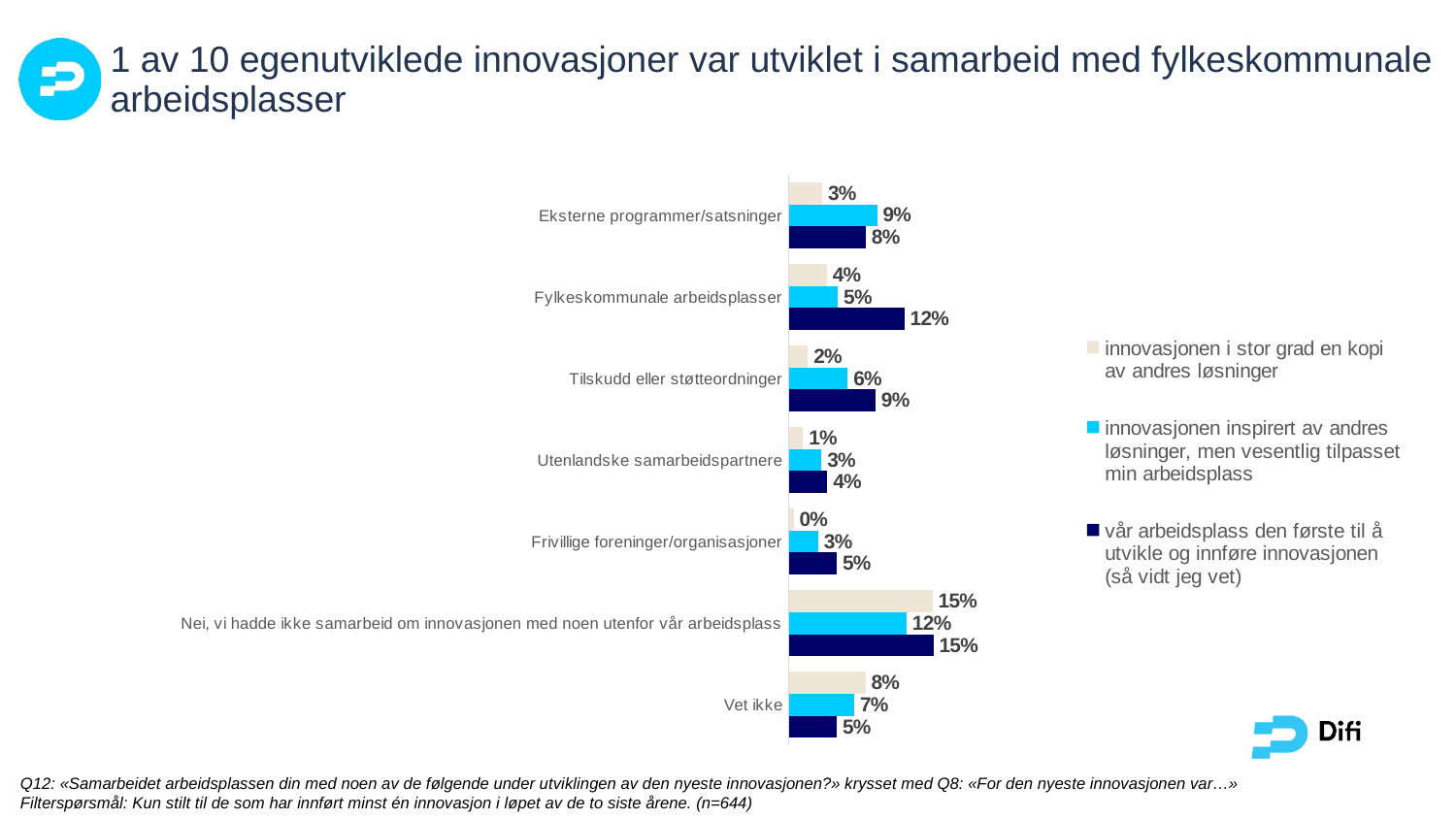
How many categories are shown on the chart? 7 What is the value for Frivillige foreninger/organisasjoner in the series 'innovasjonen i stor grad en kopi av andres løsninger'? 0% Which category has the highest value in the series 'innovasjonen i stor grad en kopi av andres løsninger'? Nei, vi hadde ikke samarbeid om innovasjonen med noen utenfor vår arbeidsplass What is the value for Eksterne programmer/satsninger in the series 'innovasjonen inspirert av andres løsninger, men vesentlig tilpasset min arbeidsplass'? 9% What is the difference between the 'vår arbeidsplass den første til å utvikle og innføre innovasjonen (så vidt jeg vet)' value and the 'innovasjonen i stor grad en kopi av andres løsninger' value for Tilskudd eller støtteordninger? 7% Which category has the lowest value in the series 'innovasjonen inspirert av andres løsninger, men vesentlig tilpasset min arbeidsplass'? Utenlandske samarbeidspartnere and Frivillige foreninger/organisasjoner (both 3%) Which colour represents the series 'vår arbeidsplass den første til å utvikle og innføre innovasjonen (så vidt jeg vet)'? dark blue What is the value for Vet ikke in the series 'innovasjonen i stor grad en kopi av andres løsninger'? 8% What is the value for Fylkeskommunale arbeidsplasser in the series 'vår arbeidsplass den første til å utvikle og innføre innovasjonen (så vidt jeg vet)'? 12% For Vet ikke, which is larger: the value for 'innovasjonen i stor grad en kopi av andres løsninger' or the value for 'vår arbeidsplass den første til å utvikle og innføre innovasjonen (så vidt jeg vet)'? innovasjonen i stor grad en kopi av andres løsninger How many series does the legend list? 3 What kind of chart is shown on the slide? bar chart